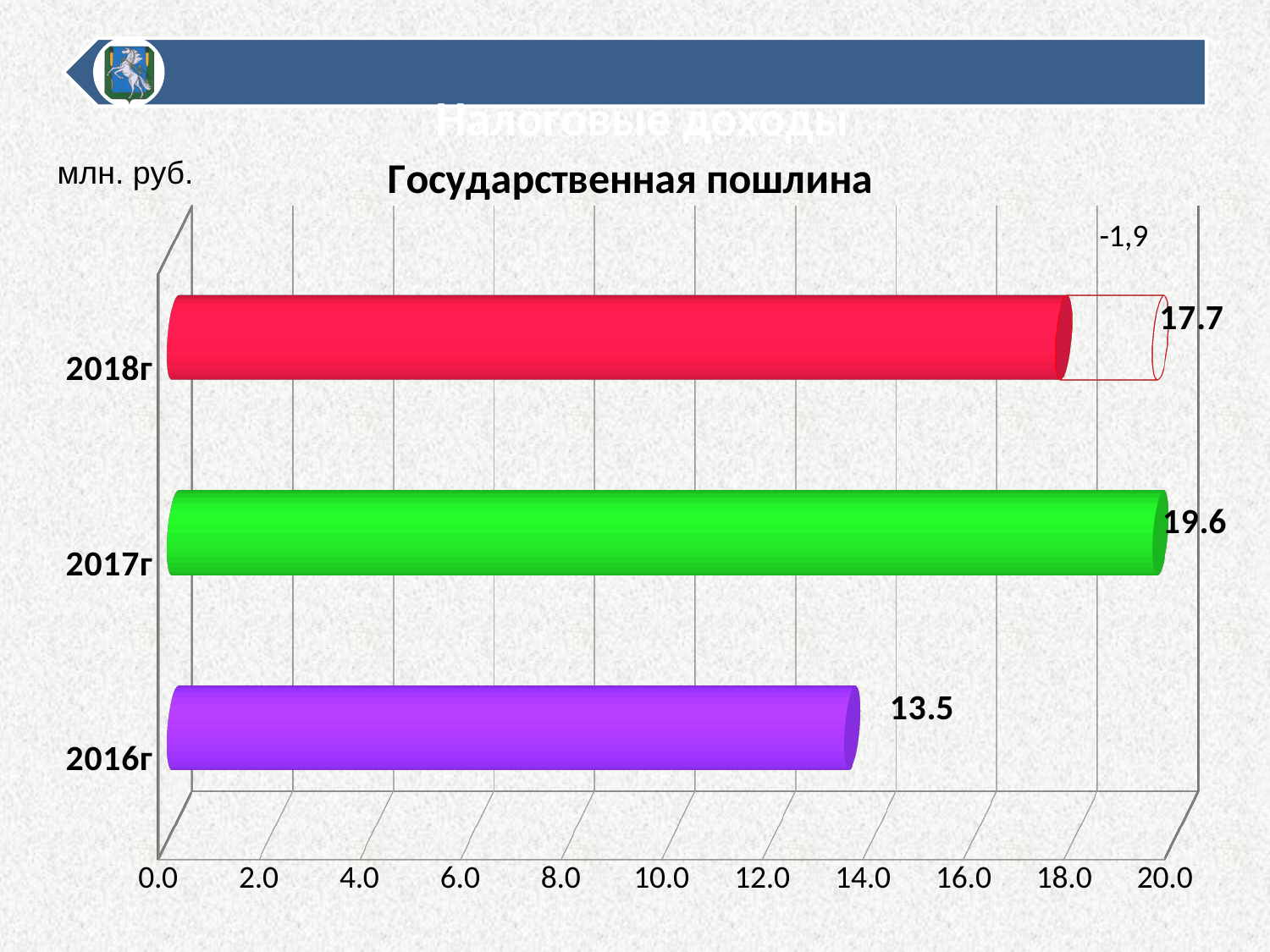
How many years (categories) are shown in the Государственная пошлина chart? 3 What unit of measurement is indicated for the Государственная пошлина chart? млн. руб. What is the difference between the values for 2017г and 2016г in the Государственная пошлина chart? 6.1 What is the value for 2016г in the Государственная пошлина chart? 13.5 What is the value for 2017г in the Государственная пошлина chart? 19.6 What is the title of the chart on the slide? Государственная пошлина Which year has the highest value in the Государственная пошлина chart? 2017г Which year has the lowest value in the Государственная пошлина chart? 2016г Which is larger in the Государственная пошлина chart, the value for 2018г or the value for 2016г? 2018г What kind of chart is used for Государственная пошлина? Bar chart What is the value for 2018г in the Государственная пошлина chart? 17.7 What is the difference between the values for 2017г and 2018г in the Государственная пошлина chart? 1.9